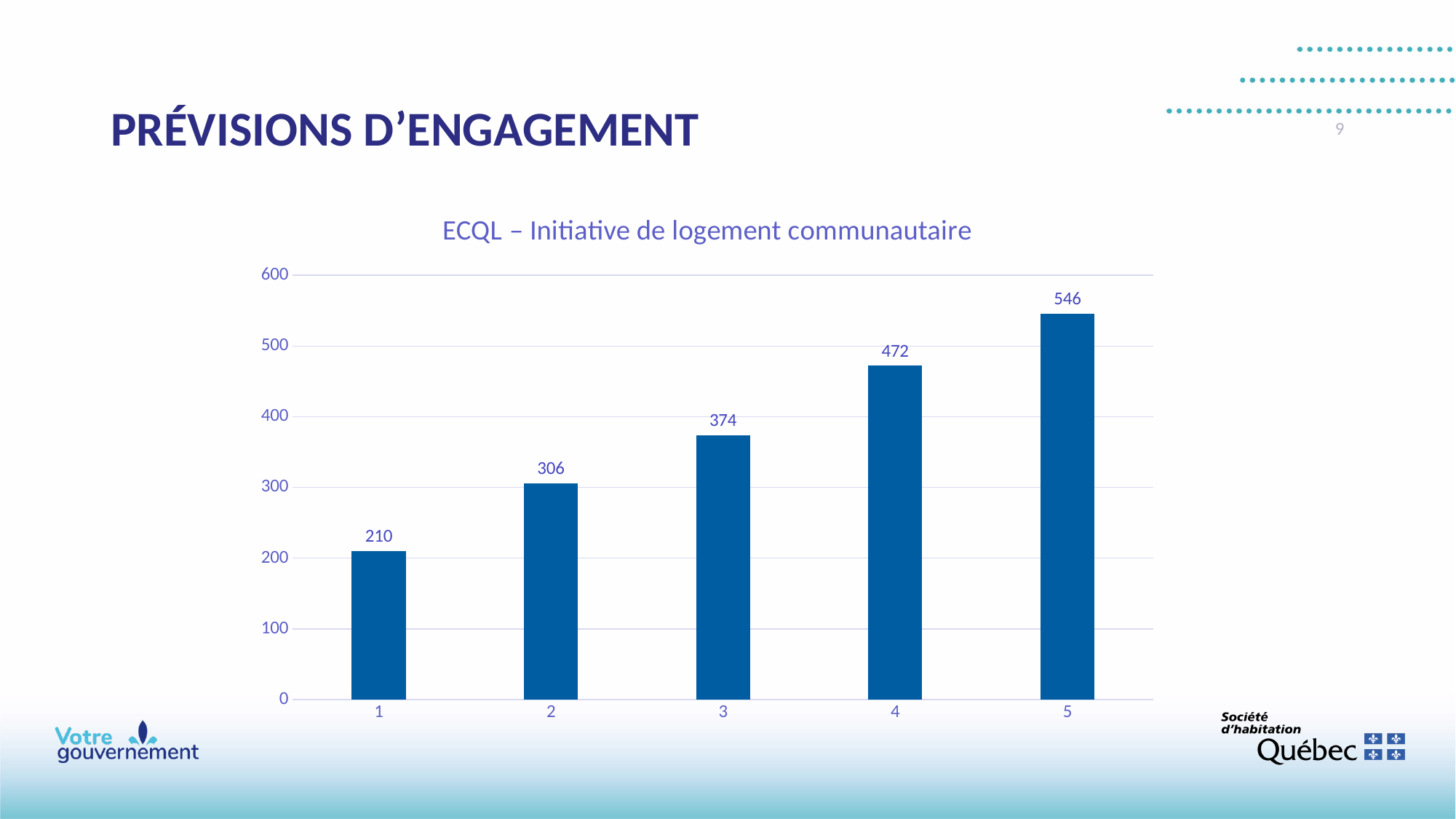
Do the values rise or fall from category 1 to category 5? rise What kind of chart is shown on the slide? bar chart Which is larger, the value for category 2 or the value for category 4? 4 How many bars are shown in the chart? 5 Which category has the highest value? 5 What is the value for category 1? 210 Is the value for category 3 greater or less than 400? less What is the value for category 5? 546 What is the value for category 3? 374 Which category has the lowest value? 1 What is the difference between the values for category 2 and category 1? 96 What is the difference between the values for category 5 and category 4? 74